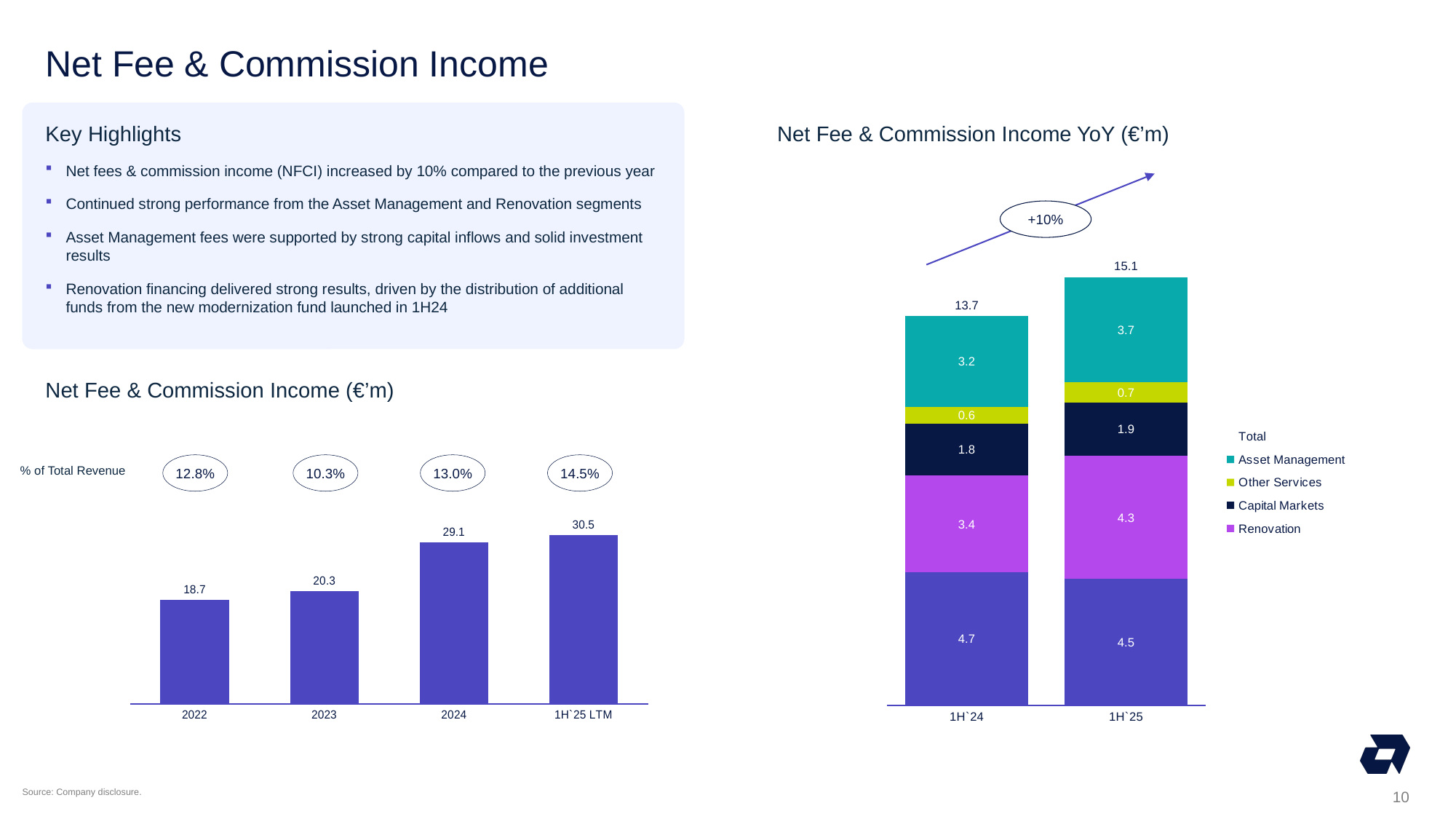
What kind of chart is the 'Net Fee & Commission Income YoY (€'m)' chart? stacked bar chart In the 'Net Fee & Commission Income (€'m)' chart, what is the difference between the 1H`25 LTM value and the 2022 value? 11.8 In the 'Net Fee & Commission Income YoY (€'m)' chart, what is the Asset Management value for 1H`25? 3.7 In the 'Net Fee & Commission Income YoY (€'m)' chart, which is larger: Capital Markets in 1H`24 or Capital Markets in 1H`25? 1H`25 In the 'Net Fee & Commission Income (€'m)' chart, do the values rise or fall from 2022 to 1H`25 LTM? rise In the 'Net Fee & Commission Income (€'m)' chart, which year has the lowest value? 2022 In the 'Net Fee & Commission Income (€'m)' chart, how many bars are plotted? 4 In the 'Net Fee & Commission Income (€'m)' chart, what % of Total Revenue is shown above the 2023 bar? 10.3% In the 'Net Fee & Commission Income YoY (€'m)' chart, what is the Renovation value for 1H`24? 3.4 In the 'Net Fee & Commission Income (€'m)' chart, what is the value for 2024? 29.1 In the 'Net Fee & Commission Income YoY (€'m)' chart, what is the difference between the Renovation values for 1H`25 and 1H`24? 0.9 In the 'Net Fee & Commission Income YoY (€'m)' chart, what is the total of the 1H`25 stacked bar? 15.1